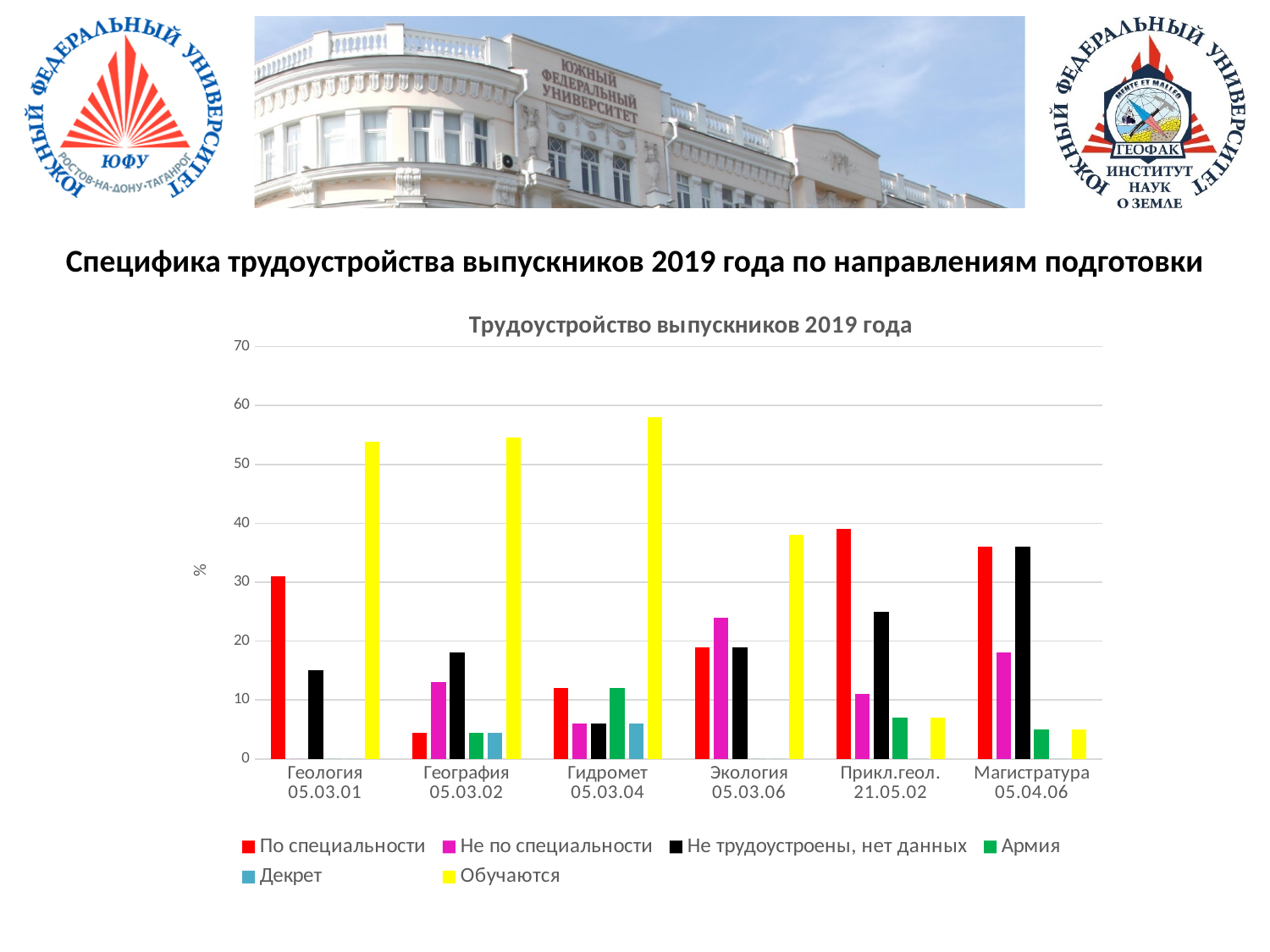
Is the value of 'Не трудоустроены, нет данных' for Геология 05.03.01 greater or less than 20? less Which category has the highest value for the series 'Обучаются'? Гидромет 05.03.04 How many categories (directions of training) are shown on the x axis of the chart? 6 Is the value of 'Обучаются' for Гидромет 05.03.04 greater or less than 50? greater How many series does the chart legend list? 6 What kind of chart is shown on the slide? bar chart Which colour represents the series 'Обучаются' in the chart? yellow Is the value of 'По специальности' for Прикл.геол. 21.05.02 greater or less than 30? greater For Гидромет 05.03.04, which is larger: 'Армия' or 'Декрет'? Армия What is the title of the chart? Трудоустройство выпускников 2019 года For Экология 05.03.06, which is larger: 'По специальности' or 'Не по специальности'? Не по специальности